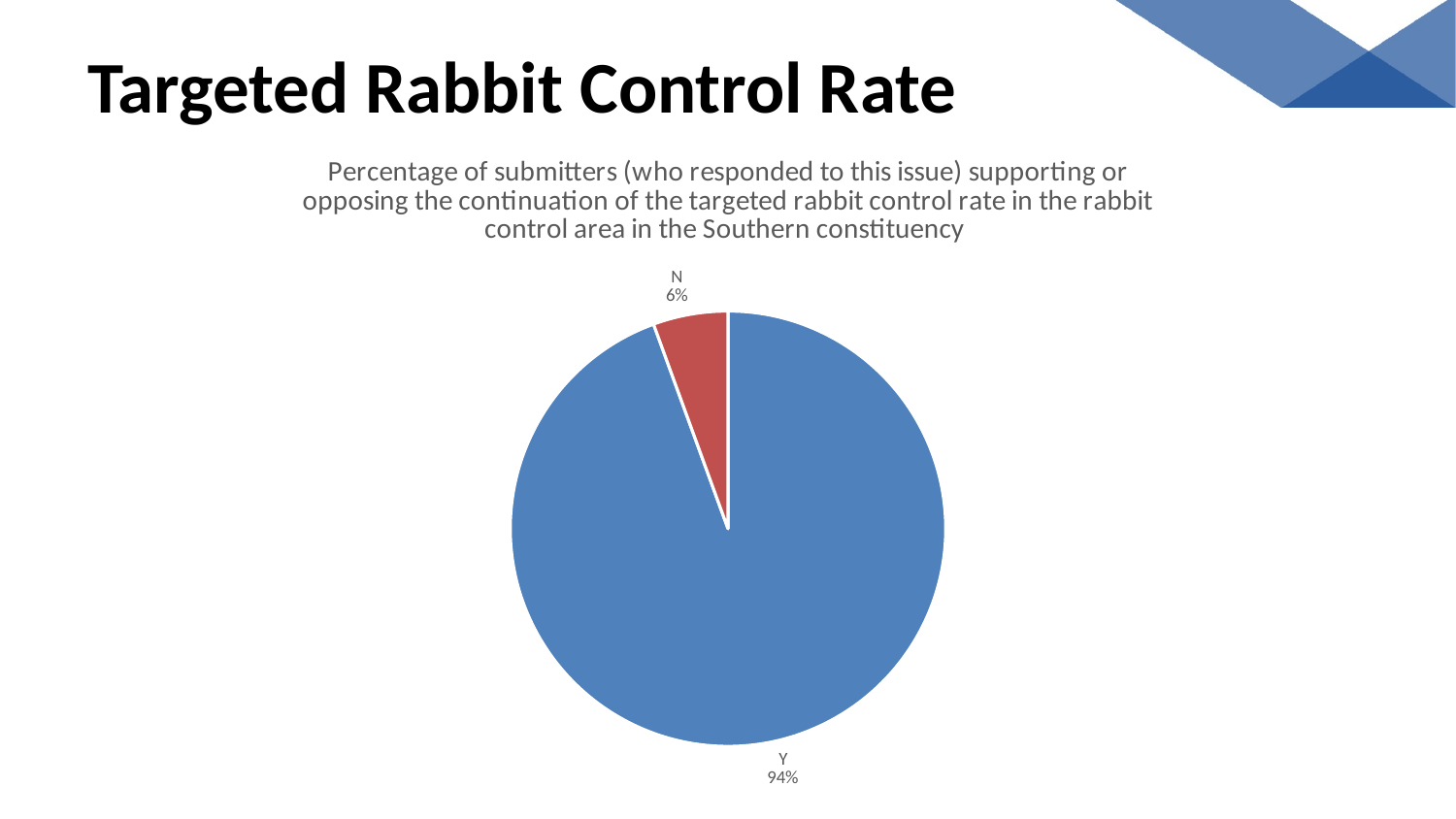
What kind of chart is shown on the slide? pie chart What colour is the Y slice of the pie? blue What is the difference in percentage points between the Y slice and the N slice? 88 Which is larger, the Y slice or the N slice? Y What percentage of submitters is shown for the Y slice? 94% Which slice of the pie is the largest? Y Which slice of the pie is the smallest? N How many slices does the pie chart have? 2 What colour is the N slice of the pie? red What share of the pie does the N slice represent? 6% What percentage of submitters is shown for the N slice? 6%